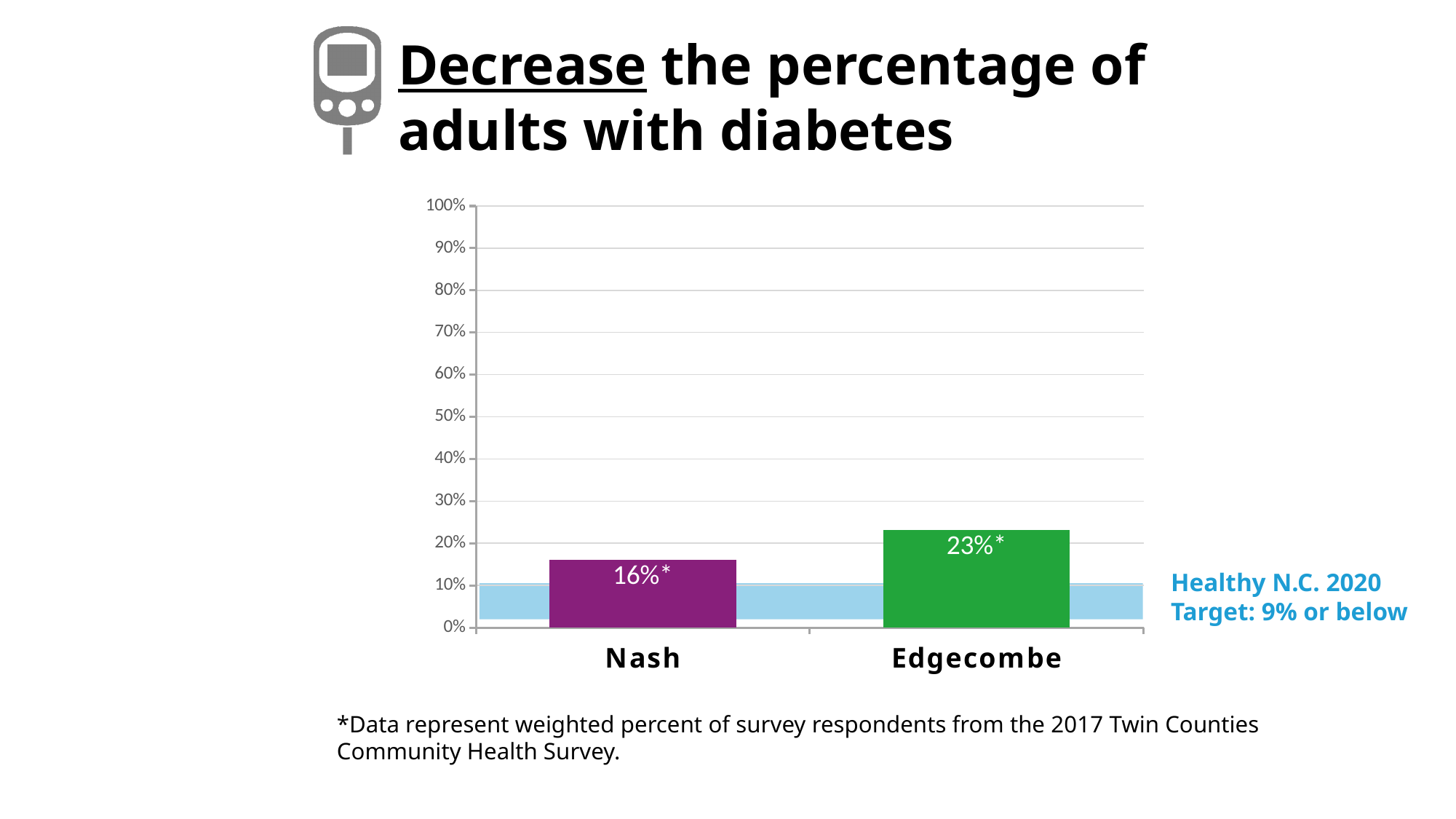
What is the difference in percentage points between Edgecombe and Nash? 7 percentage points What is the Healthy N.C. 2020 target shown on the chart? 9% or below Which county has the higher percentage of adults with diabetes? Edgecombe Which county has the lower percentage of adults with diabetes? Nash What kind of chart is shown on the slide? Bar chart Is the value for Nash greater or less than 20%? less What is the percentage of adults with diabetes in Nash? 16% What is the maximum value shown on the vertical axis? 100% What is the percentage of adults with diabetes in Edgecombe? 23% Is the value for Nash greater or less than the 9% target? greater Is the value for Edgecombe greater or less than 20%? greater How many counties are shown on the chart? 2